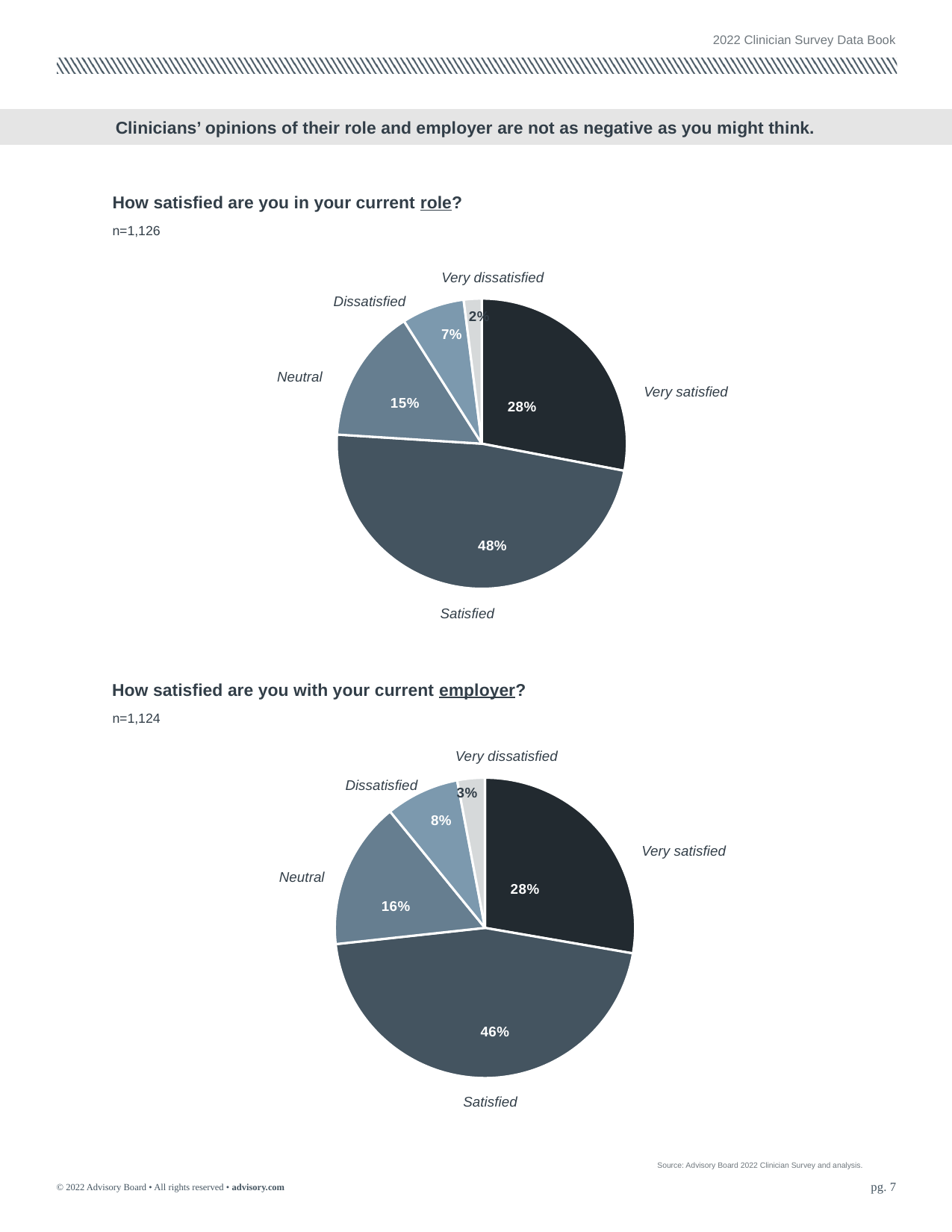
In the 'How satisfied are you with your current employer?' chart, which is larger: Neutral or Dissatisfied? Neutral In the 'How satisfied are you with your current employer?' chart, what percentage of respondents are Dissatisfied? 8% In the 'How satisfied are you in your current role?' chart, which category has the largest share? Satisfied In the 'How satisfied are you with your current employer?' chart, what percentage of respondents are Neutral? 16% In the 'How satisfied are you with your current employer?' chart, which category has the smallest share? Very dissatisfied In the 'How satisfied are you with your current employer?' chart, what is the combined share of Very satisfied and Satisfied? 74% In the 'How satisfied are you in your current role?' chart, what is the difference between the Satisfied and Very satisfied shares? 20 percentage points In the 'How satisfied are you in your current role?' chart, what percentage of respondents are Very dissatisfied? 2% What is the sample size (n) shown for the 'How satisfied are you in your current role?' chart? n=1,126 What type of chart is used for 'How satisfied are you with your current employer?'? Pie chart How many categories does the 'How satisfied are you in your current role?' chart show? 5 In the 'How satisfied are you in your current role?' chart, what percentage of respondents are Satisfied? 48%